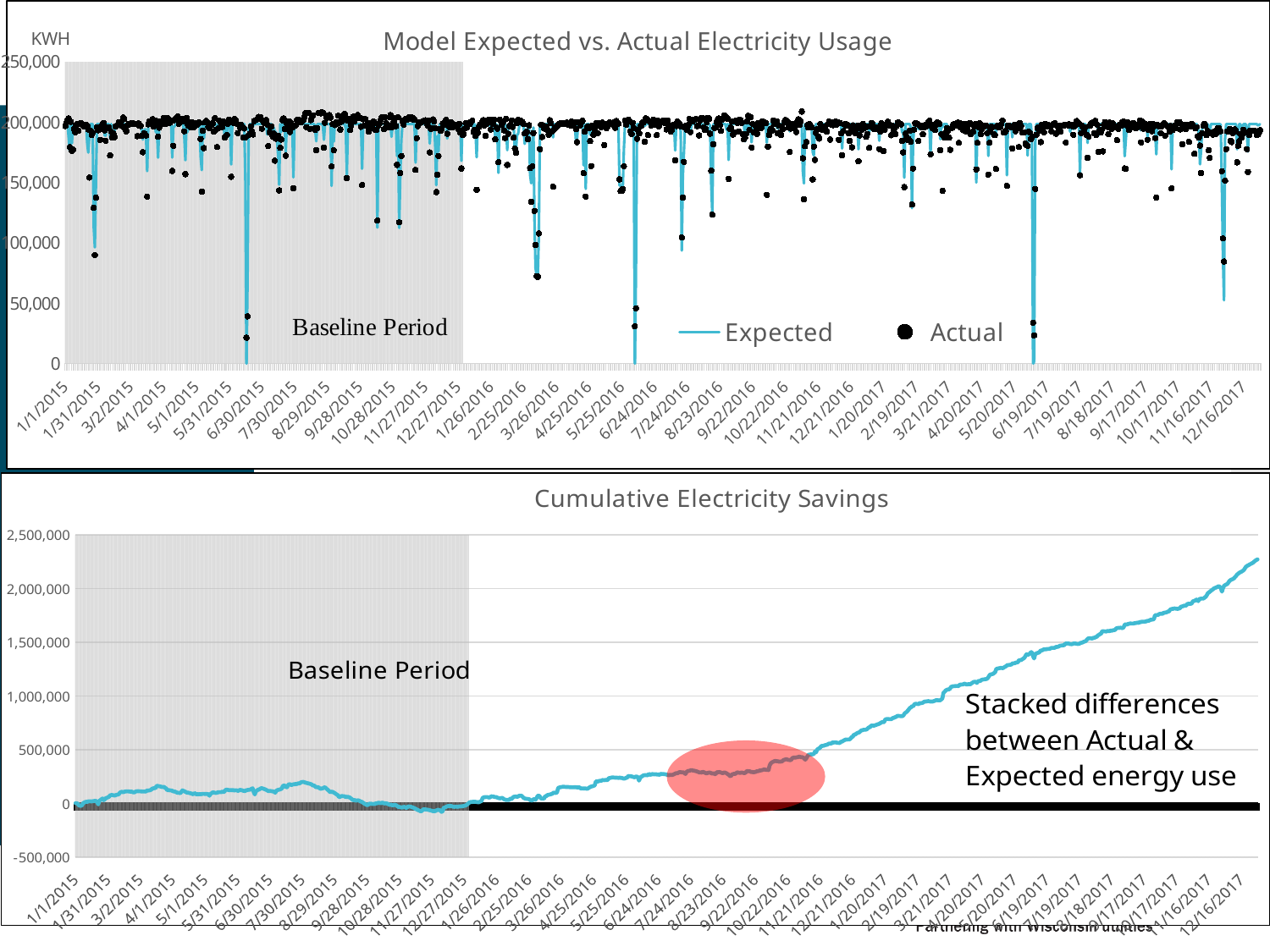
In the top chart, how many series does the legend list? 2 In the bottom chart, is the cumulative savings value at 12/16/2017 greater or less than 2,000,000? greater In the top chart, what kind of chart is used to show the Expected series? Line chart What is the title of the bottom chart? Cumulative Electricity Savings In the bottom chart, is the cumulative savings value at 12/16/2017 larger or smaller than the value at 1/26/2016? larger In the bottom chart, is the cumulative savings value at 6/19/2017 greater or less than 1,000,000? greater In the bottom chart, do the cumulative savings values generally rise or fall after the Baseline Period ends? Rise In the top chart, is the Expected value on 1/1/2015 greater or less than 150,000? greater What kind of chart is the bottom chart, Cumulative Electricity Savings? Line chart In the top chart, what kind of chart is used to show the Actual series? Scatter (dots) What is the title of the top chart? Model Expected vs. Actual Electricity Usage